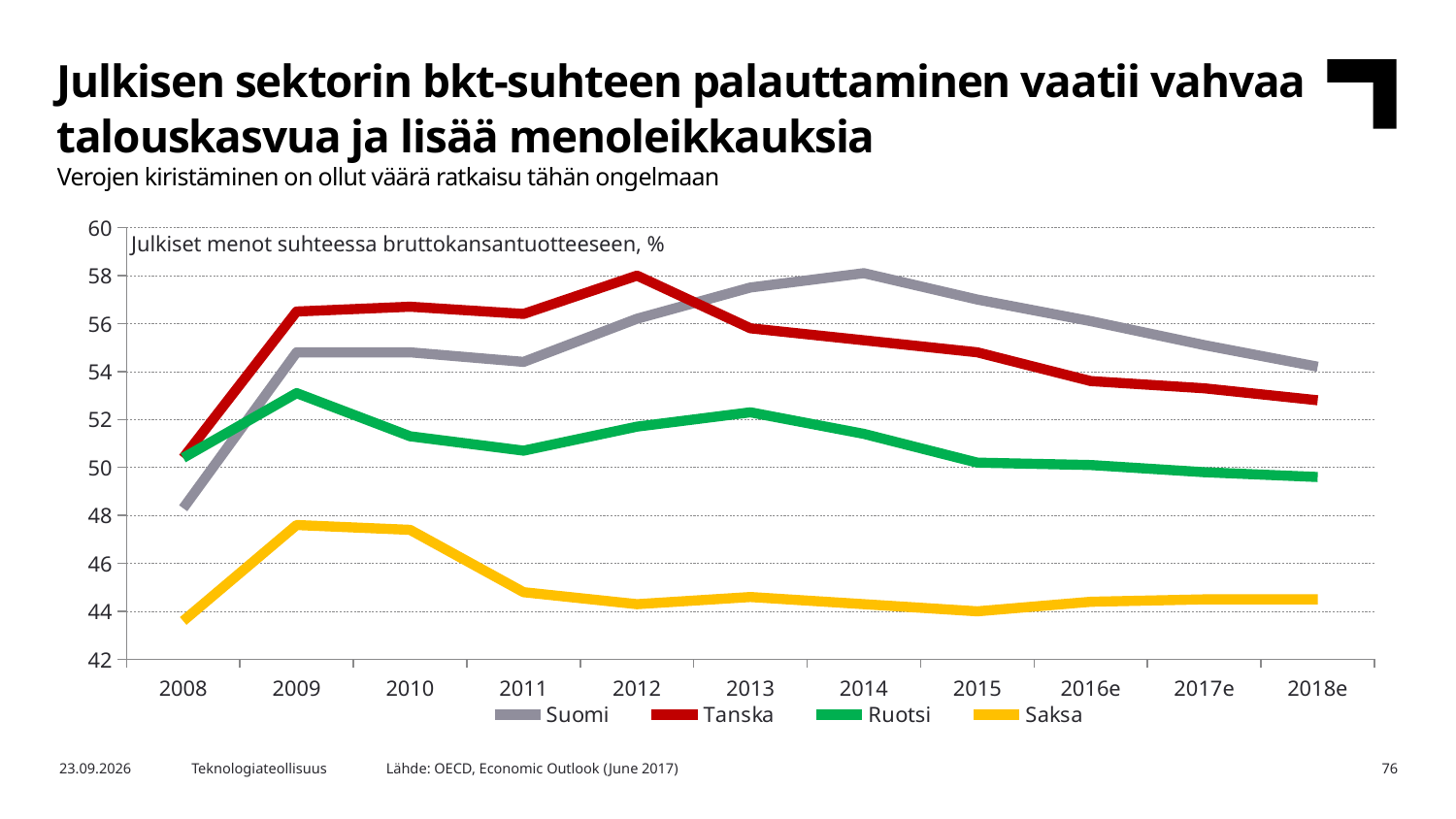
How many years are shown on the x axis? 11 How many series does the legend list? 4 Which series has the lowest values across all years shown? Saksa In which year does the Suomi line reach its highest point? 2014 Which is larger in 2014, the value for Suomi or the value for Tanska? Suomi What kind of chart is shown on the slide? line chart Does the Suomi line rise or fall from 2014 to 2018e? fall Is the value for Suomi in 2014 greater or less than 56? greater Which series has the highest value in 2018e? Suomi Is the value for Suomi in 2008 greater or less than 50? less What are the four series listed in the legend? Suomi, Tanska, Ruotsi, Saksa In which year does the Saksa line reach its highest point? 2009